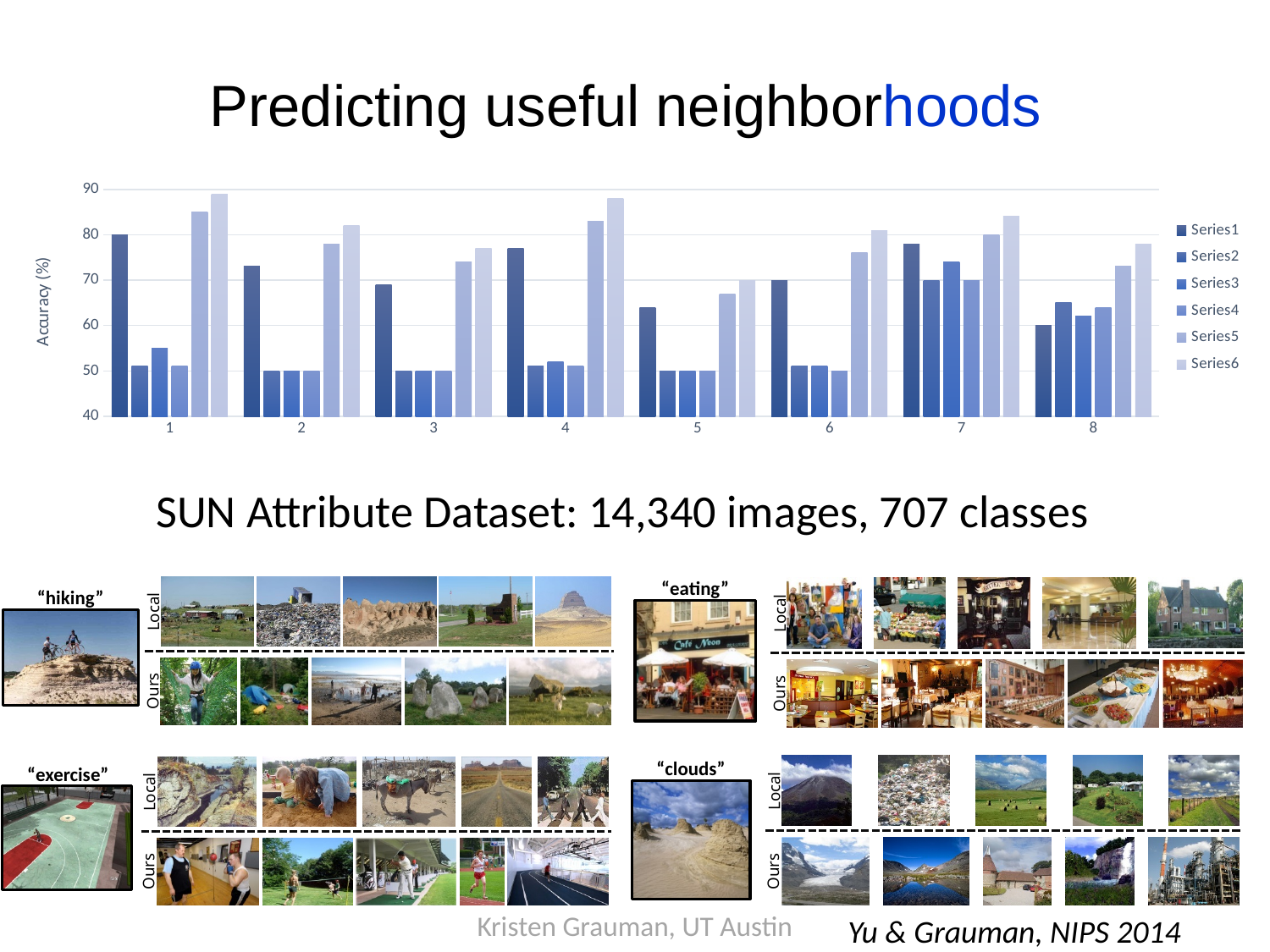
What is the label of the chart's vertical axis? Accuracy (%) How many categories are shown along the x axis of the chart? 8 Is the value for Series1 in category 5 greater or less than 60? greater In category 1, which is larger: the Series1 bar or the Series6 bar? Series6 Is the value for Series3 in category 1 greater or less than 50? greater Which series has the highest bar in category 1? Series6 Is the value for Series6 in category 4 greater or less than 80? greater How many series does the chart's legend list? 6 In category 8, which is larger: the Series1 bar or the Series6 bar? Series6 What kind of chart is shown on the slide? bar chart